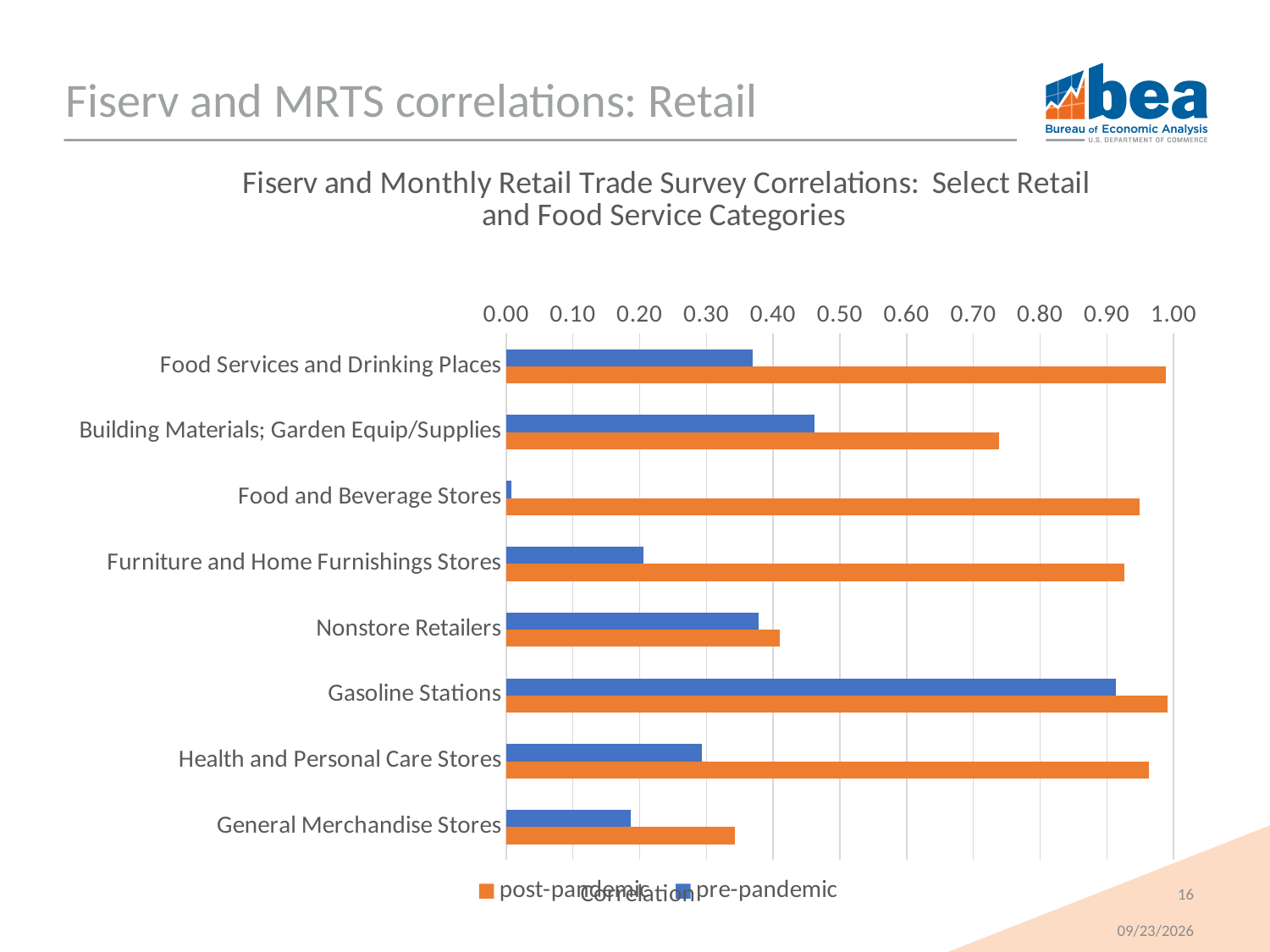
Which category has the highest pre-pandemic correlation? Gasoline Stations What kind of chart is shown on the slide? bar chart How many series does the legend list? 2 Which category has the lowest post-pandemic correlation? General Merchandise Stores What colour represents the post-pandemic series in the legend? orange Is the post-pandemic value for Building Materials; Garden Equip/Supplies greater or less than 0.80? less Is the pre-pandemic value for Gasoline Stations greater or less than 0.80? greater How many retail categories are plotted on the chart? 8 Which has the larger pre-pandemic correlation: Building Materials; Garden Equip/Supplies or Health and Personal Care Stores? Building Materials; Garden Equip/Supplies For Building Materials; Garden Equip/Supplies, which is larger: the pre-pandemic or the post-pandemic correlation? post-pandemic Which category has the lowest pre-pandemic correlation? Food and Beverage Stores Is the pre-pandemic value for Food Services and Drinking Places greater or less than 0.30? greater